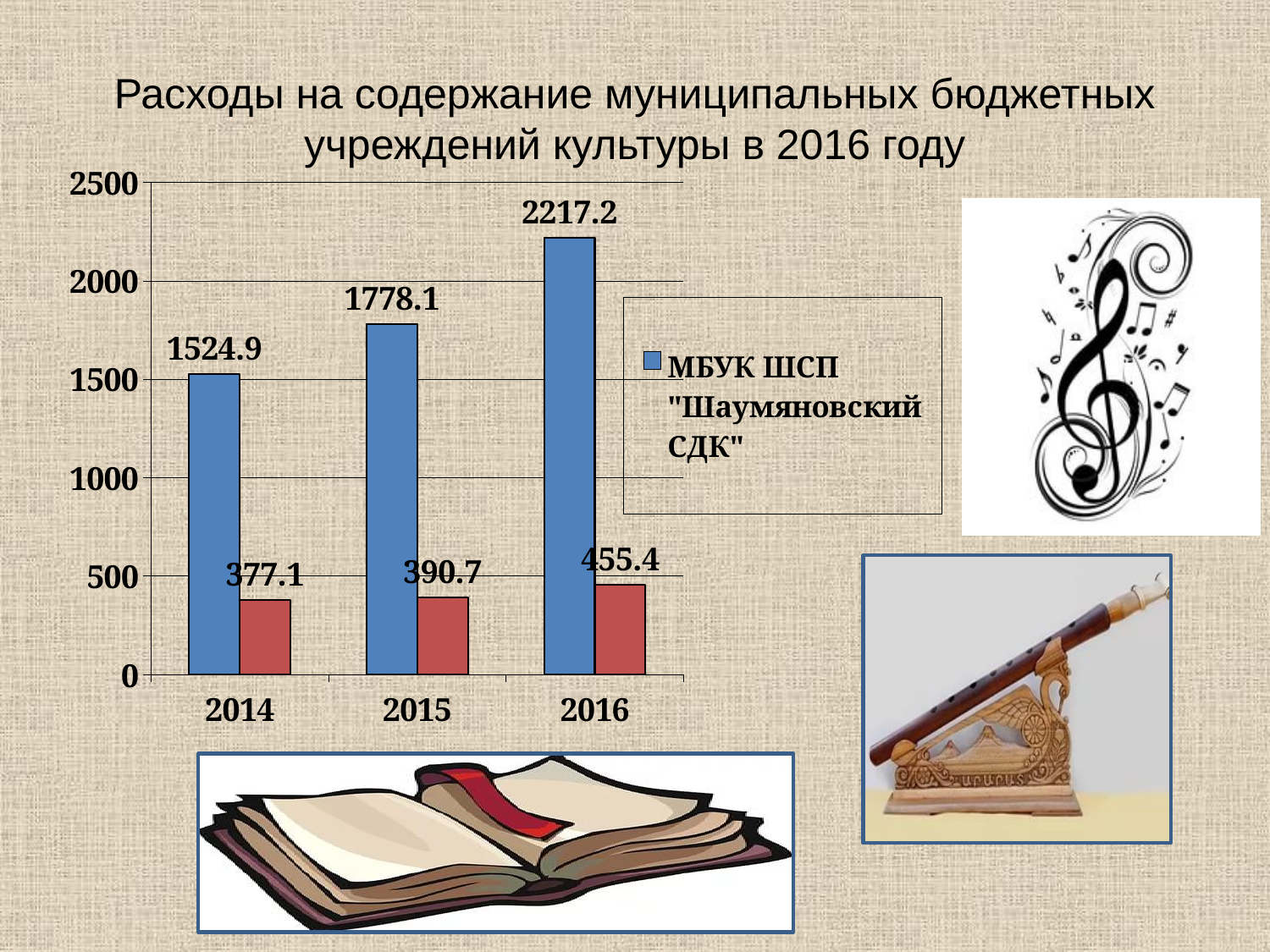
Do the values for МБУК ШСП "Шаумяновский СДК" rise or fall from 2014 to 2016? Rise What is the value for МБУК ШСП "Шаумяновский СДК" in 2016? 2217.2 Which is larger: the blue bar for 2014 or the red bar for 2016? The blue bar for 2014 What is the value for МБУК ШСП "Шаумяновский СДК" in 2015? 1778.1 How many years are shown on the x axis of the chart? 3 What is the value of the red bar for 2014? 377.1 What type of chart is shown on the slide? Bar chart In which year is the red bar the lowest? 2014 By how much did the value for МБУК ШСП "Шаумяновский СДК" increase from 2014 to 2016? 692.3 What is the difference between the red bar values for 2016 and 2015? 64.7 In which year is the value for МБУК ШСП "Шаумяновский СДК" the highest? 2016 What is the value of the red bar for 2016? 455.4